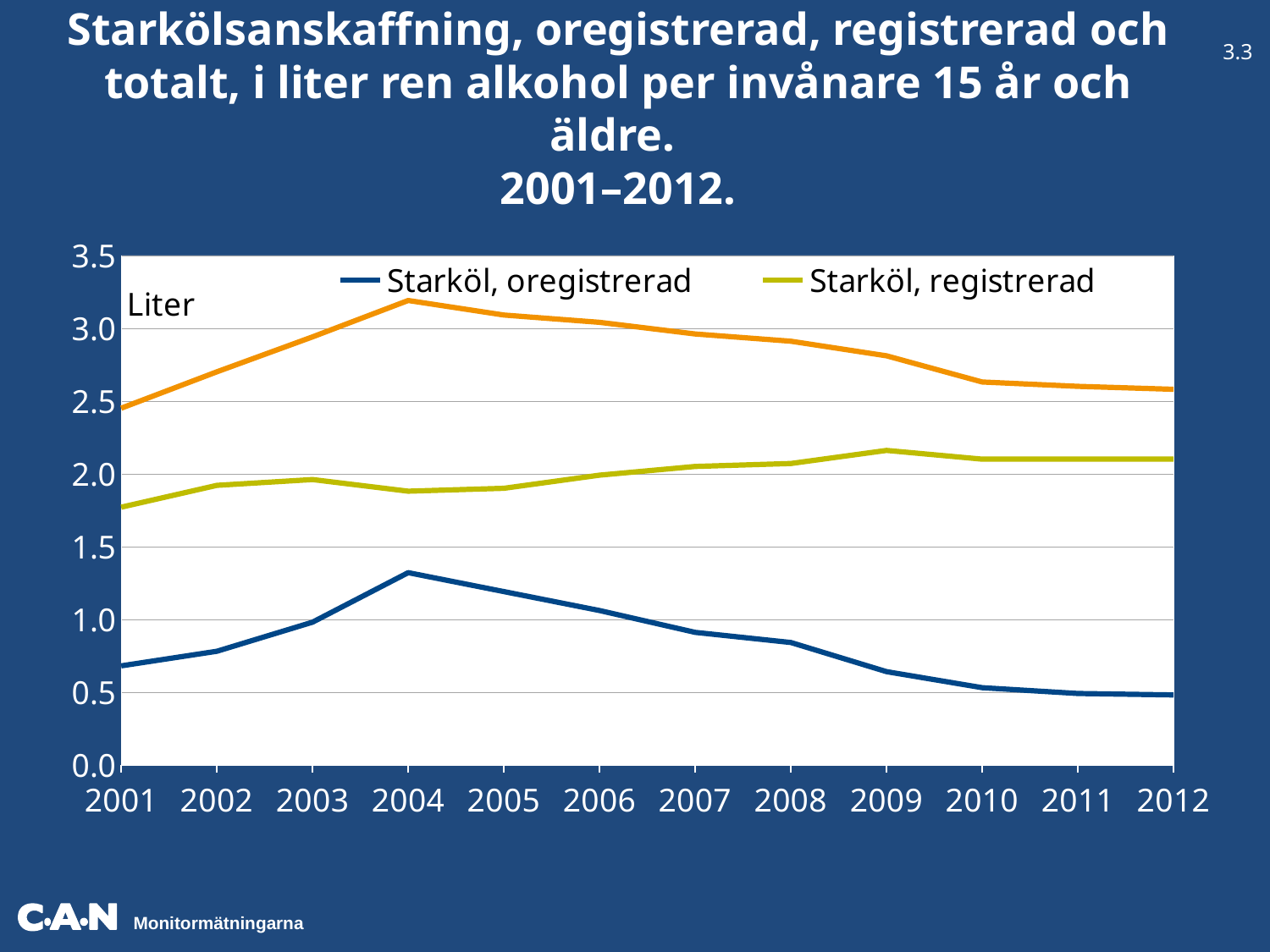
What kind of chart is shown on the slide? line chart In 2004, which is larger: Starköl, oregistrerad or Starköl, registrerad? Starköl, registrerad What unit label is shown at the top left of the plot area? Liter How many series does the chart's legend list? 2 Is the value for Starköl, oregistrerad in 2001 greater or less than 1.0? less How many years are shown on the x axis of the chart? 12 Is the value for Starköl, oregistrerad in 2004 greater or less than 1.0? greater Is the value for Starköl, registrerad in 2001 greater or less than 2.0? less In which year does the Starköl, oregistrerad line reach its highest value? 2004 In which year does the Starköl, registrerad line reach its highest value? 2009 In which year is the Starköl, registrerad value lowest? 2001 Does the Starköl, oregistrerad line rise or fall from 2004 to 2012? fall